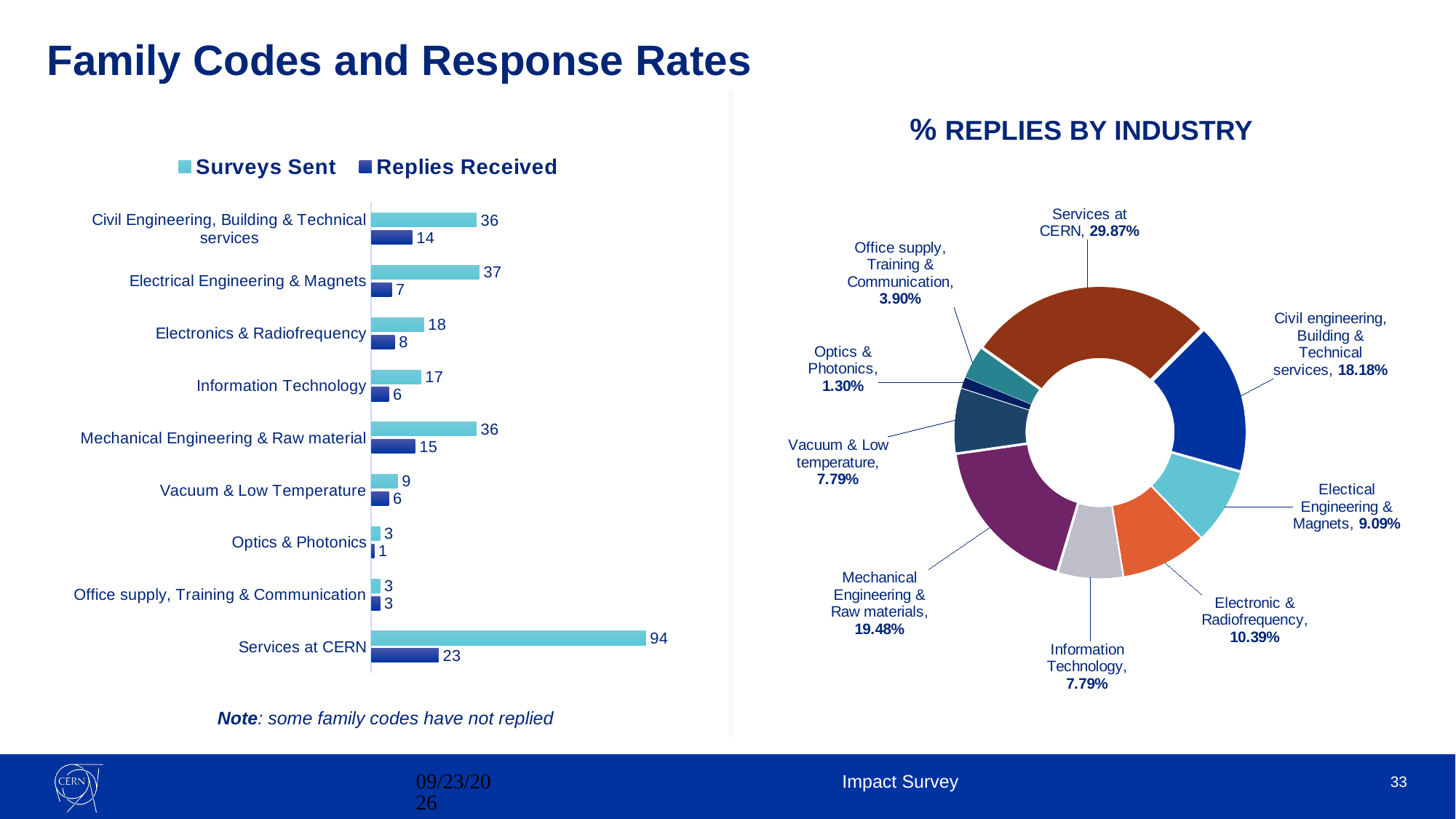
In the bar chart on the left, which category has the lowest number of replies received? Optics & Photonics How many categories are shown in the bar chart on the left? 9 In the bar chart on the left, how many surveys were sent to Services at CERN? 94 In the bar chart on the left, which is larger: replies received from Civil Engineering, Building & Technical services or from Electronics & Radiofrequency? Civil Engineering, Building & Technical services What kind of chart is the chart on the left? Bar chart What is the title of the chart on the right? % REPLIES BY INDUSTRY In the bar chart on the left, what is the difference between surveys sent and replies received for Electrical Engineering & Magnets? 30 How many series does the legend of the bar chart on the left list? 2 In the bar chart on the left, which category has the highest number of surveys sent? Services at CERN In the bar chart on the left, how many replies were received from Mechanical Engineering & Raw material? 15 In the '% REPLIES BY INDUSTRY' chart, what share of replies comes from Mechanical Engineering & Raw materials? 19.48% In the '% REPLIES BY INDUSTRY' chart, which industry has the smallest share of replies? Optics & Photonics